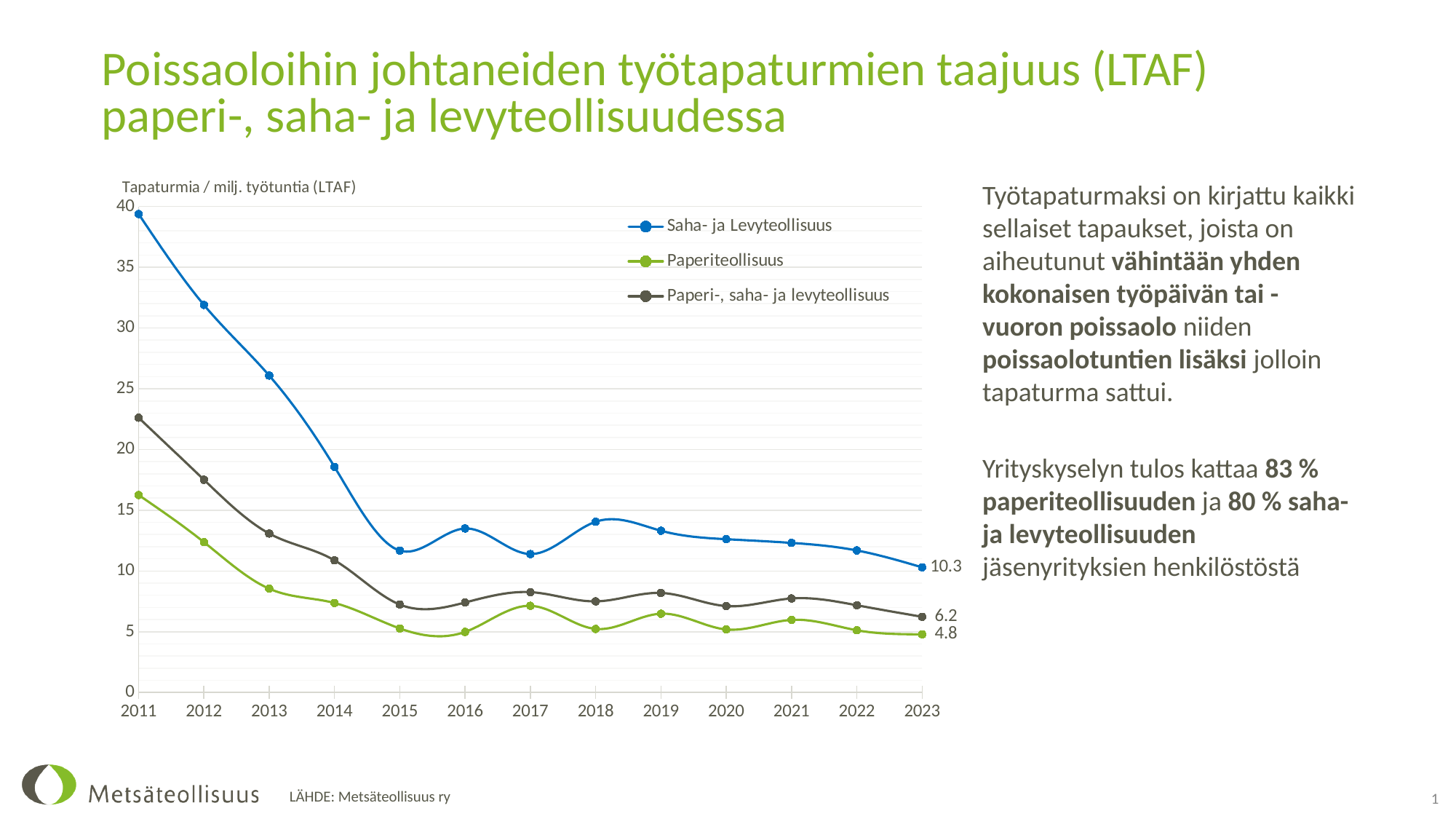
Which series has the highest value in 2011? Saha- ja Levyteollisuus Is the value for Saha- ja Levyteollisuus in 2011 greater or less than 35? greater Is the value for Paperiteollisuus in 2011 greater or less than 20? less What is the value for Saha- ja Levyteollisuus in 2023? 10.3 What is the value for Paperi-, saha- ja levyteollisuus in 2023? 6.2 What is the label shown above the y axis? Tapaturmia / milj. työtuntia (LTAF) What kind of chart is shown on the slide? line chart How many series does the legend list? 3 Does the Saha- ja Levyteollisuus series rise or fall from 2011 to 2023? fall How many years are shown on the x axis? 13 What is the difference between the 2023 values for Saha- ja Levyteollisuus and Paperiteollisuus? 5.5 What is the value for Paperiteollisuus in 2023? 4.8